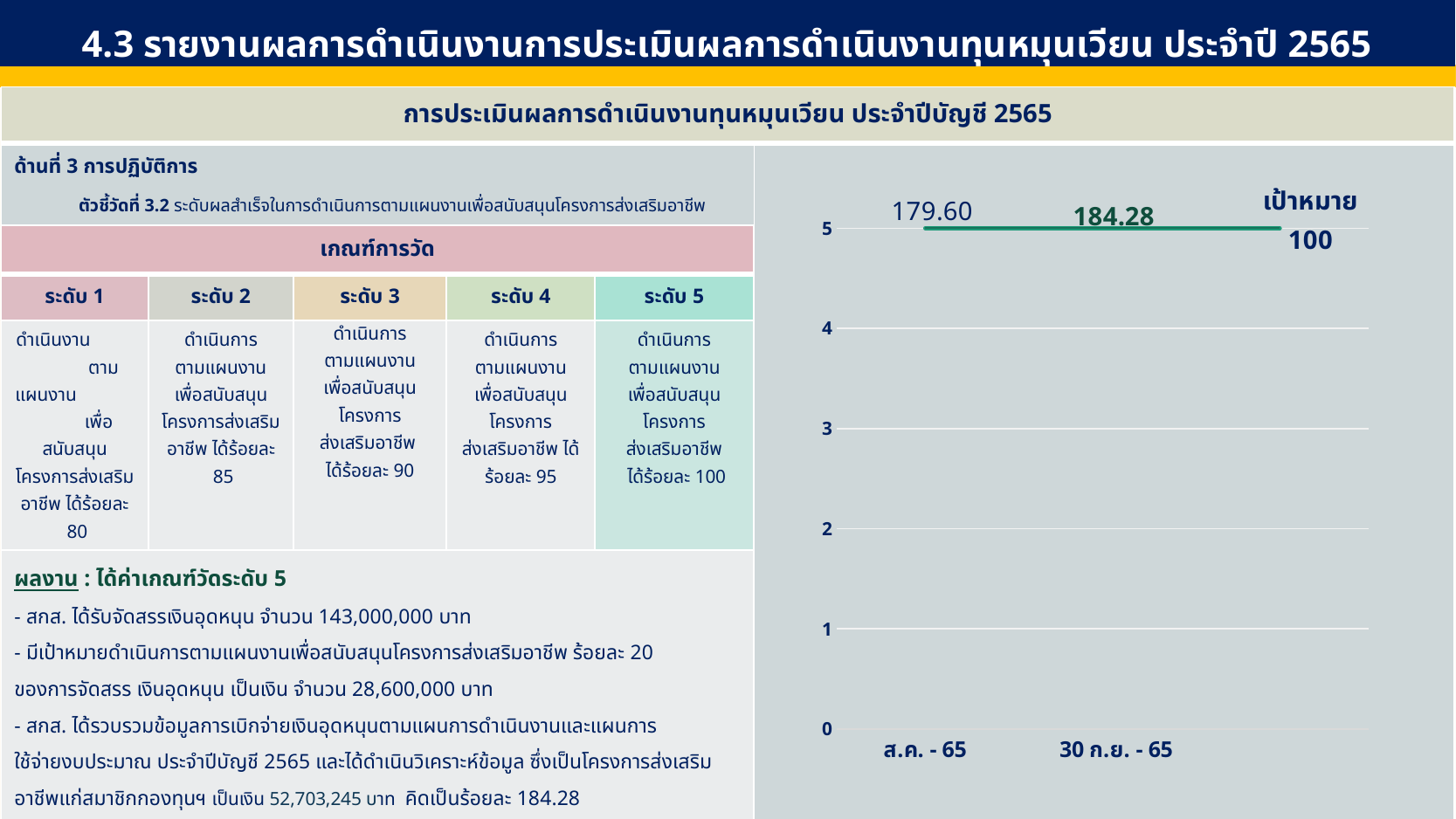
In the chart on the right, which x-axis category has the lower labelled value? ส.ค. - 65 In the chart on the right, which x-axis category has the higher labelled value? 30 ก.ย. - 65 In the chart on the right, do the labelled values rise or fall from ส.ค. - 65 to 30 ก.ย. - 65? rise In the chart on the right, what is the value labelled for 30 ก.ย. - 65? 184.28 In the chart on the right, is the value for 30 ก.ย. - 65 larger or smaller than the value for ส.ค. - 65? larger In the chart on the right, what is the value labelled for ส.ค. - 65? 179.60 How many data points are plotted in the chart on the right? 3 What kind of chart is shown on the right side of the slide? line chart What is the highest tick value shown on the y-axis of the chart on the right? 5 In the chart on the right, what target value (เป้าหมาย) is shown? 100 In the chart on the right, what is the difference between the values for 30 ก.ย. - 65 and ส.ค. - 65? 4.68